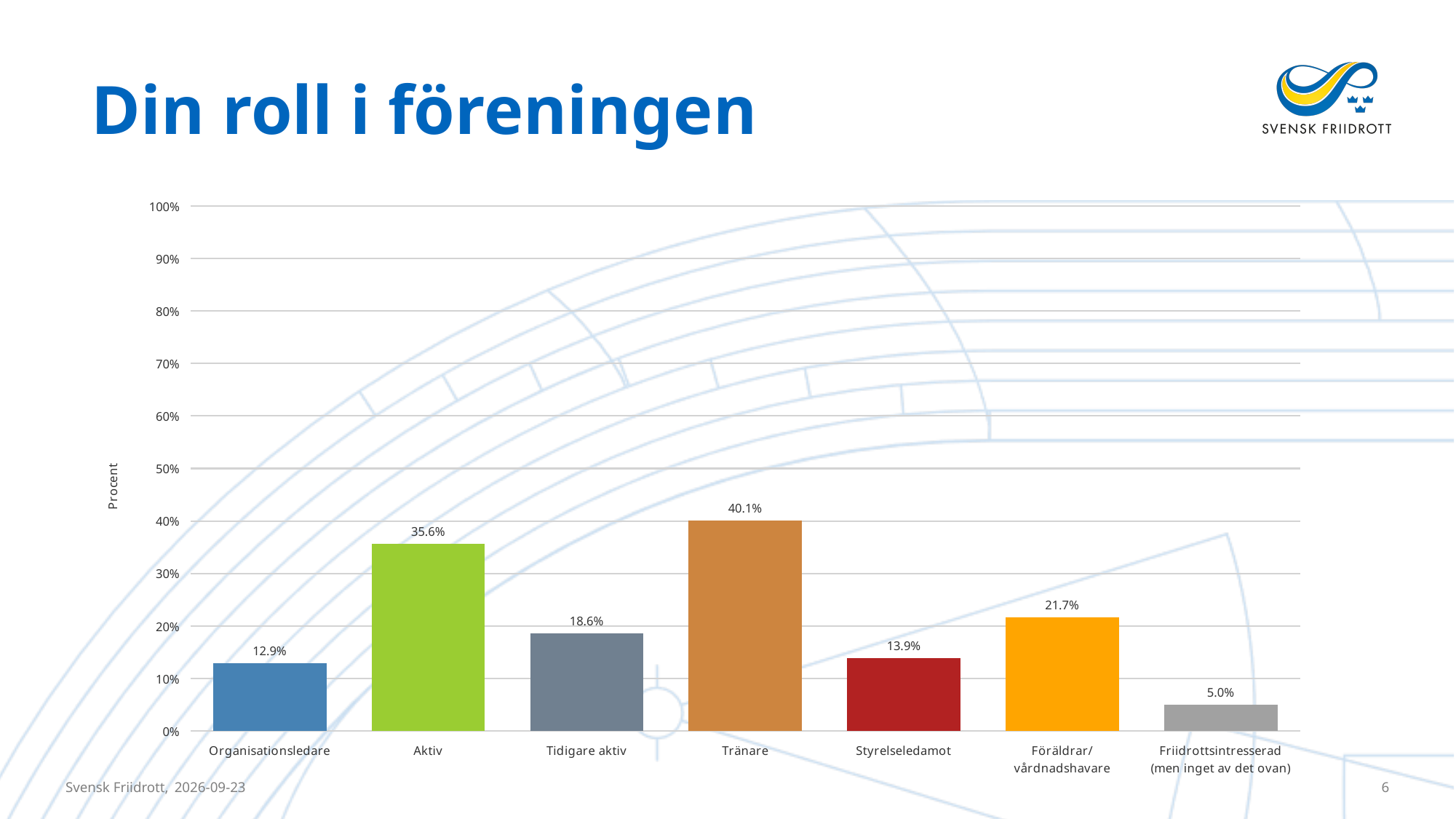
Which category has the highest value? Tränare Is the value for Styrelseledamot greater or less than 20%? less What is the value for Tränare? 40.1% How many categories are shown on the x axis? 7 Which category has the lowest value? Friidrottsintresserad (men inget av det ovan) What is the value for Föräldrar/vårdnadshavare? 21.7% What is the value for Organisationsledare? 12.9% What kind of chart is shown on the slide? bar chart Which is larger, the value for Aktiv or the value for Föräldrar/vårdnadshavare? Aktiv What is the difference between the values for Tränare and Aktiv? 4.5% What is the difference between the values for Tidigare aktiv and Styrelseledamot? 4.7% What is the label of the vertical axis? Procent